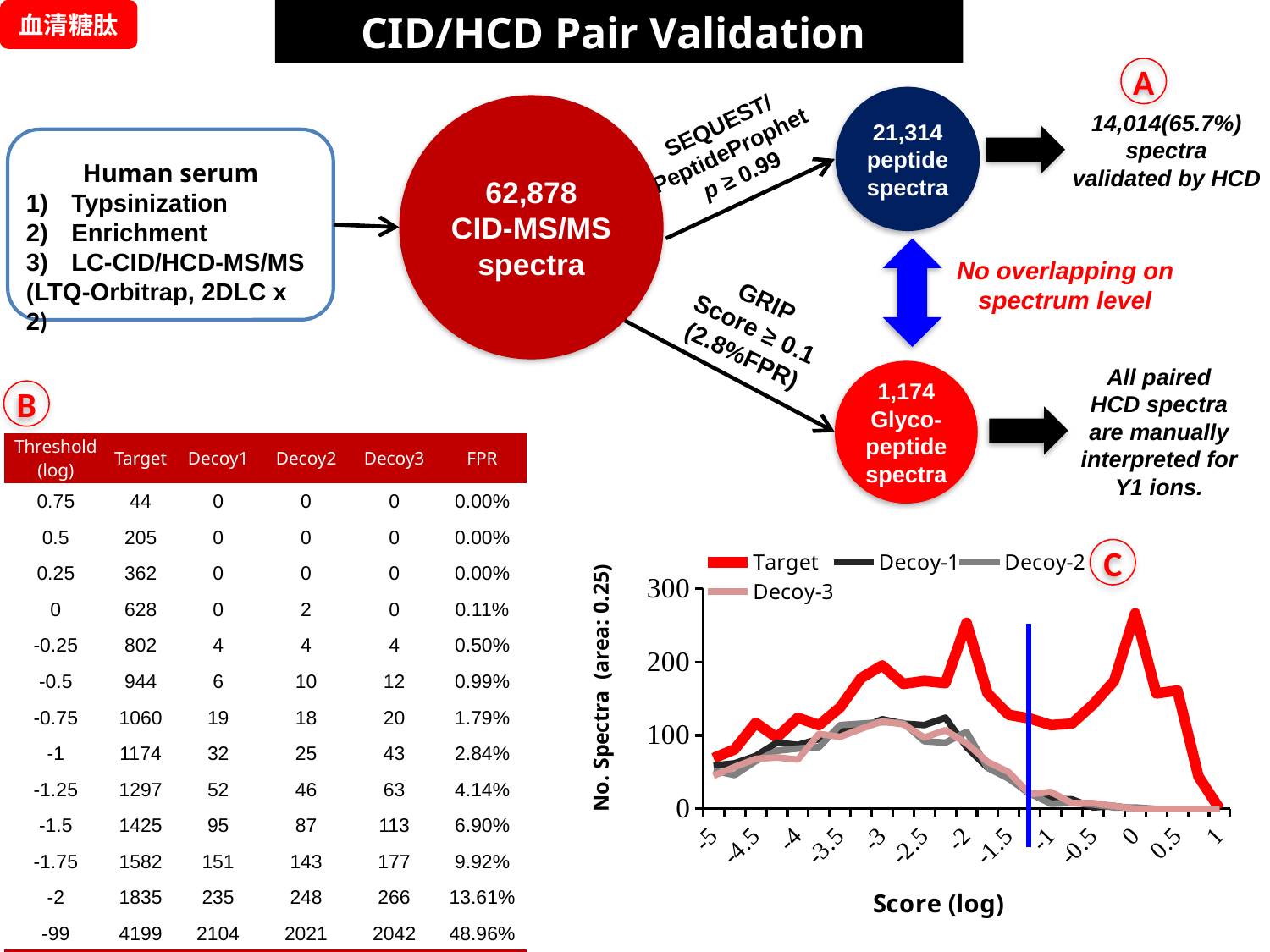
In chart C, at score 0, which series has the larger value, Target or Decoy-2? Target What are the series names listed in the legend of chart C? Target, Decoy-1, Decoy-2, Decoy-3 In chart C, is the value of the Target series at score 0 greater or less than 200? greater In chart C, is the value of the Decoy-1 series at score 0 greater or less than 100? less How many tick labels are shown on the x axis of chart C? 13 What is the x-axis title of chart C? Score (log) What kind of chart is chart C on the slide? line chart In chart C, is the value of the Target series at score -2 greater or less than 200? greater How many series does the legend of chart C list? 4 In chart C, at score -4.5, which series has the larger value, Target or Decoy-3? Target In chart C, which series reaches the highest value on the y axis? Target